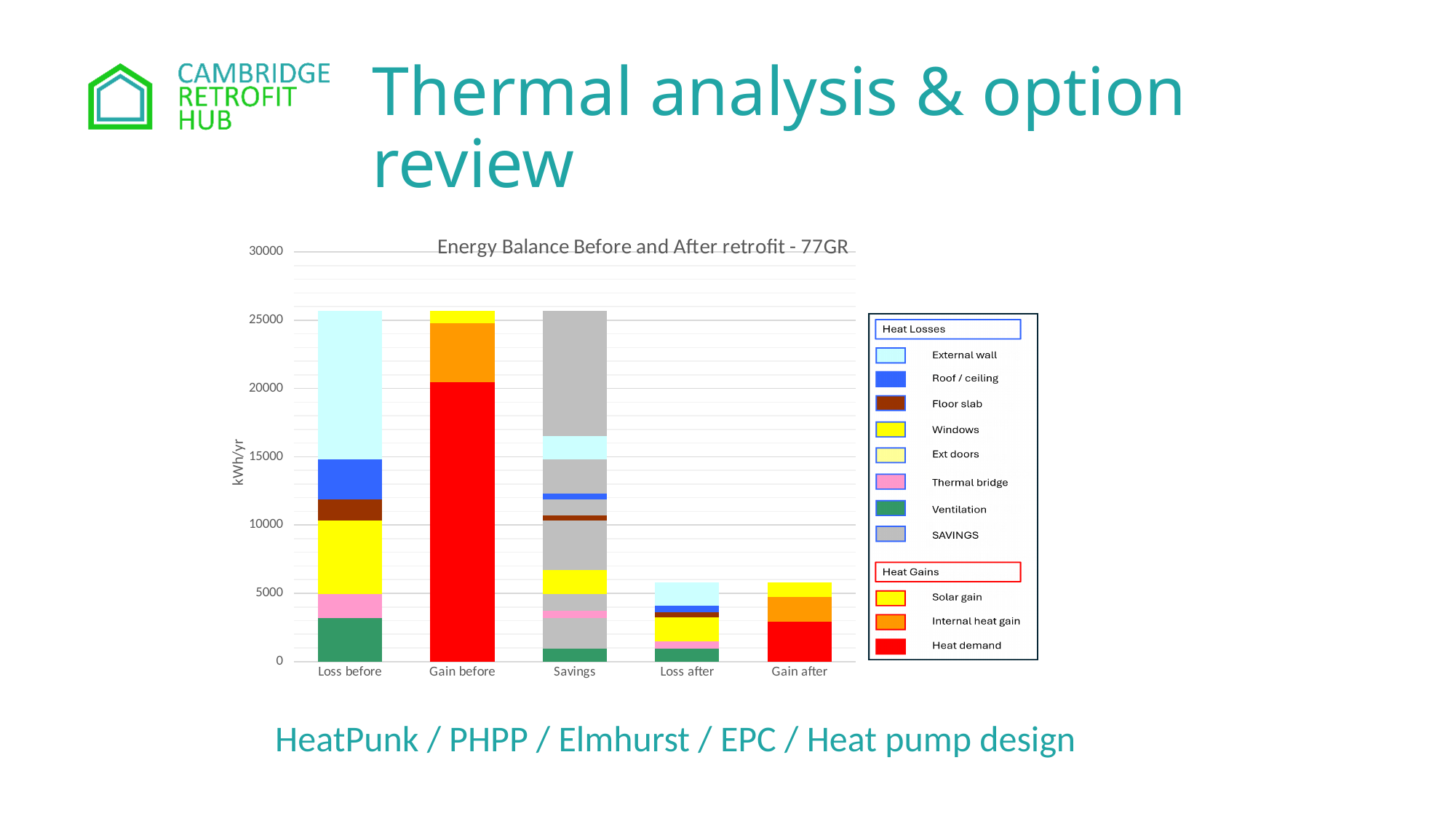
What unit is shown on the y axis of the chart? kWh/yr What kind of chart is shown on the slide? Stacked bar chart Is the total of the Loss after bar greater or less than 5000? greater Is the Heat demand value in the Gain after bar greater or less than 5000? less Is the total of the Loss after bar greater or less than 10000? less How many categories are shown on the x axis of the chart? 5 What is the title of the chart? Energy Balance Before and After retrofit - 77GR Which bar is taller, Loss before or Loss after? Loss before Which bar is taller, Gain before or Gain after? Gain before